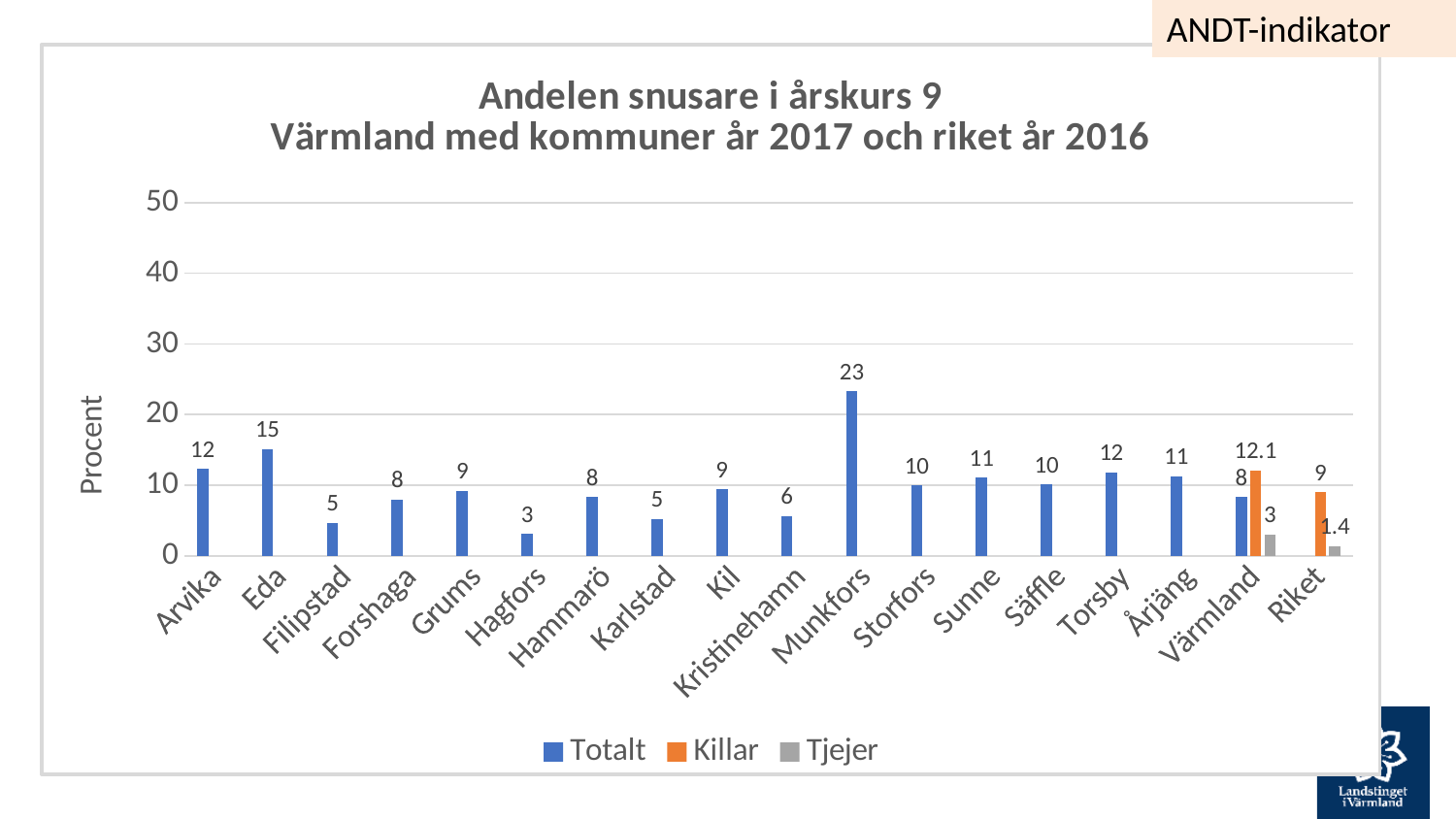
Which has a higher Totalt value, Torsby or Sunne? Torsby What is the Killar value for Värmland? 12.1 Is the Totalt value for Munkfors greater or less than 20? greater Which municipality has the lowest Totalt value? Hagfors Which municipality has the highest Totalt value? Munkfors What kind of chart is shown on the slide? Bar chart What is the Tjejer value for Riket? 1.4 What is the Totalt value for Munkfors? 23 What is the difference between the Totalt values for Munkfors and Eda? 8 How many categories are shown on the x axis? 18 How many series does the legend list? 3 What is the Totalt value for Eda? 15